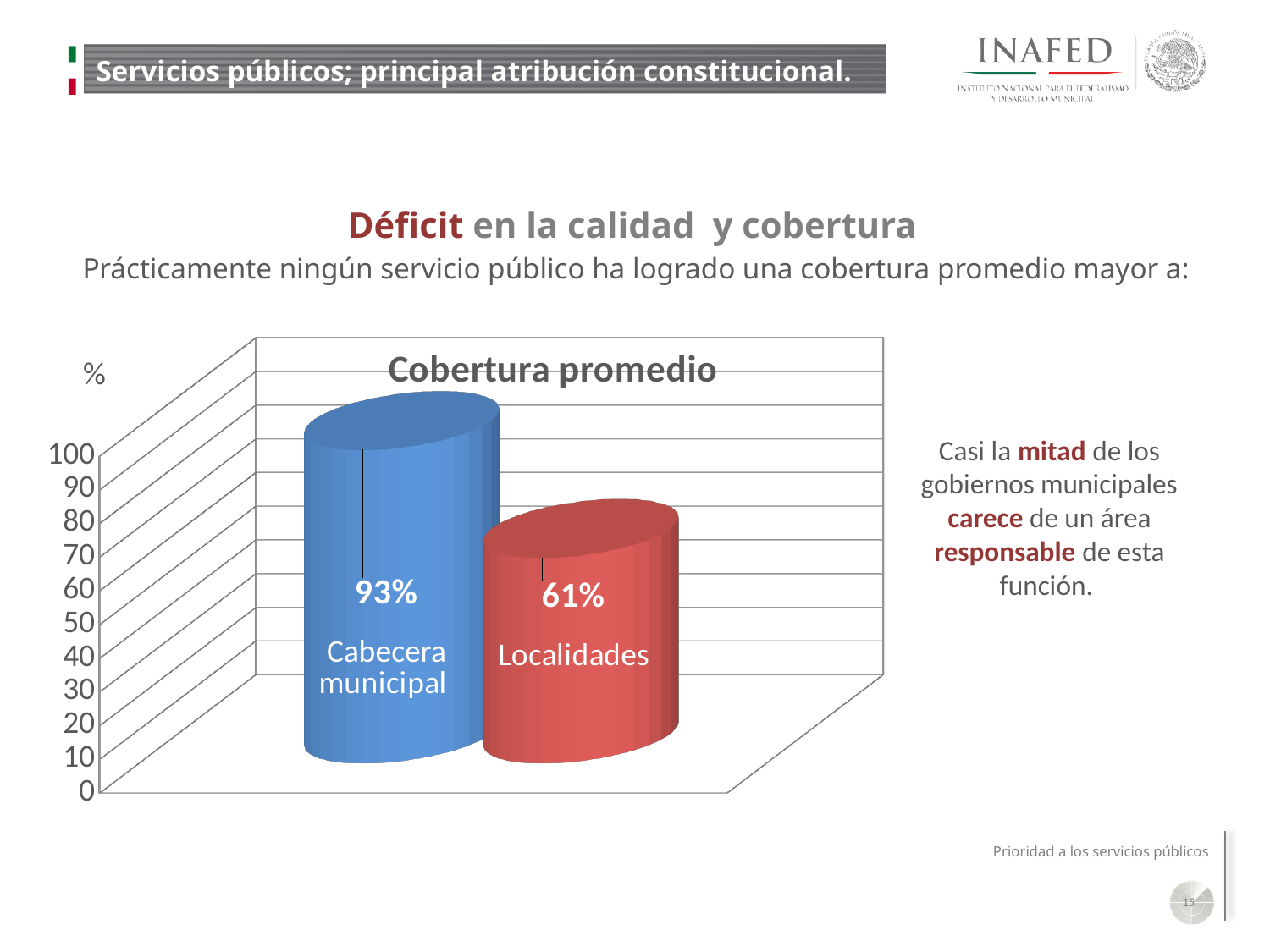
Which category has the lowest value in the Cobertura promedio chart? Localidades Which category has the highest value in the Cobertura promedio chart? Cabecera municipal What is the value for Localidades in the Cobertura promedio chart? 61% How many categories are shown in the Cobertura promedio chart? 2 What colour is the bar for Localidades? Red Is the value for Localidades greater or less than 70? less Which is larger, the value for Cabecera municipal or the value for Localidades? Cabecera municipal What is the value for Cabecera municipal in the Cobertura promedio chart? 93% What is the title of the chart on the slide? Cobertura promedio What kind of chart is shown on the slide? Bar chart Is the value for Cabecera municipal greater or less than 80? greater What is the difference between the values for Cabecera municipal and Localidades? 32%